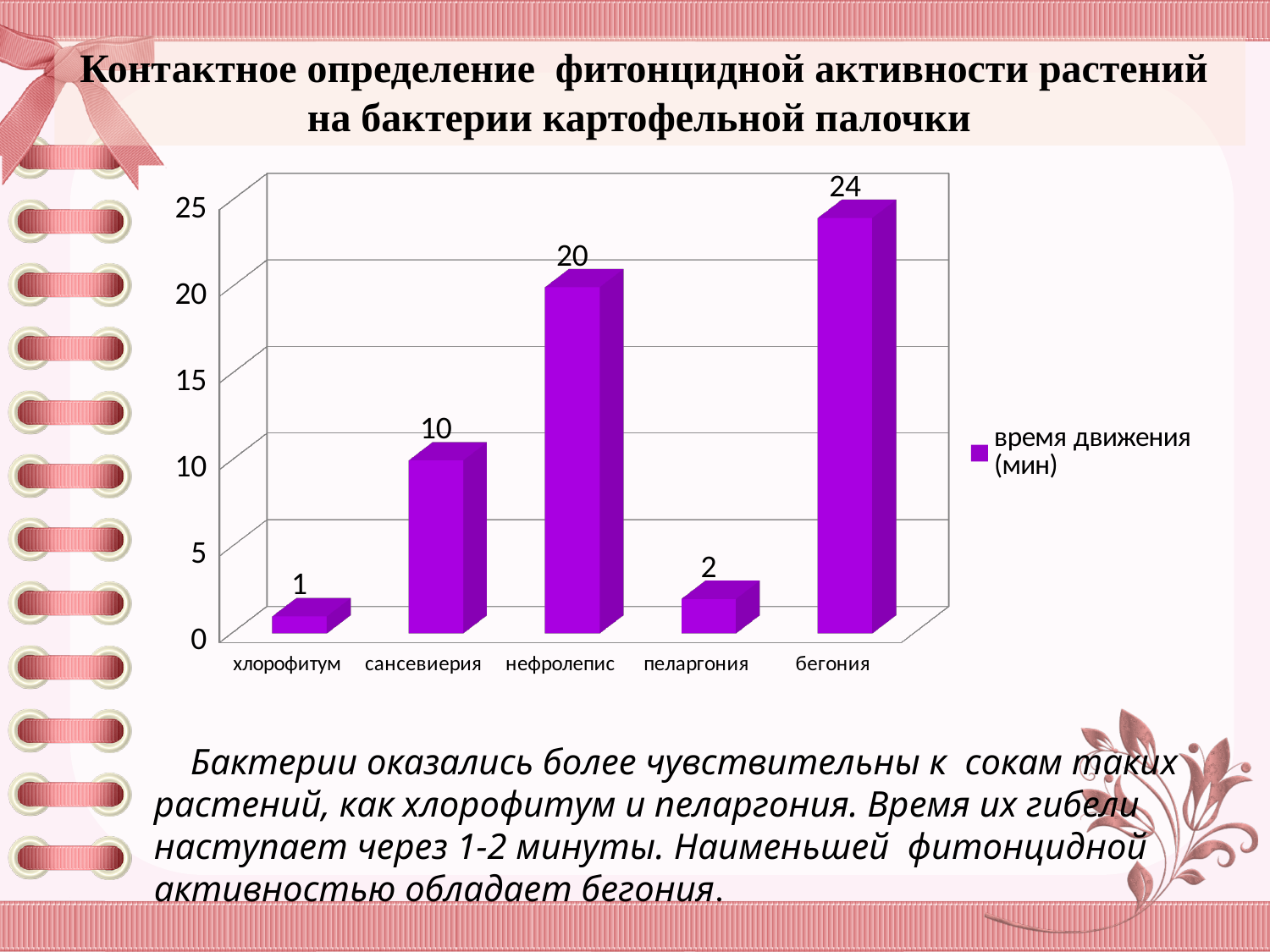
What is the value for пеларгония? 2 Which category has the lowest value? хлорофитум What is the value for бегония? 24 What kind of chart is shown on the slide? bar chart Which is larger, the value for сансевиерия or the value for пеларгония? сансевиерия How many categories are shown on the x axis? 5 How many series does the legend list? 1 What is the difference between the values for бегония and нефролепис? 4 What is the value for хлорофитум? 1 Which category has the highest value? бегония What is the value for нефролепис? 20 What is the value for сансевиерия? 10